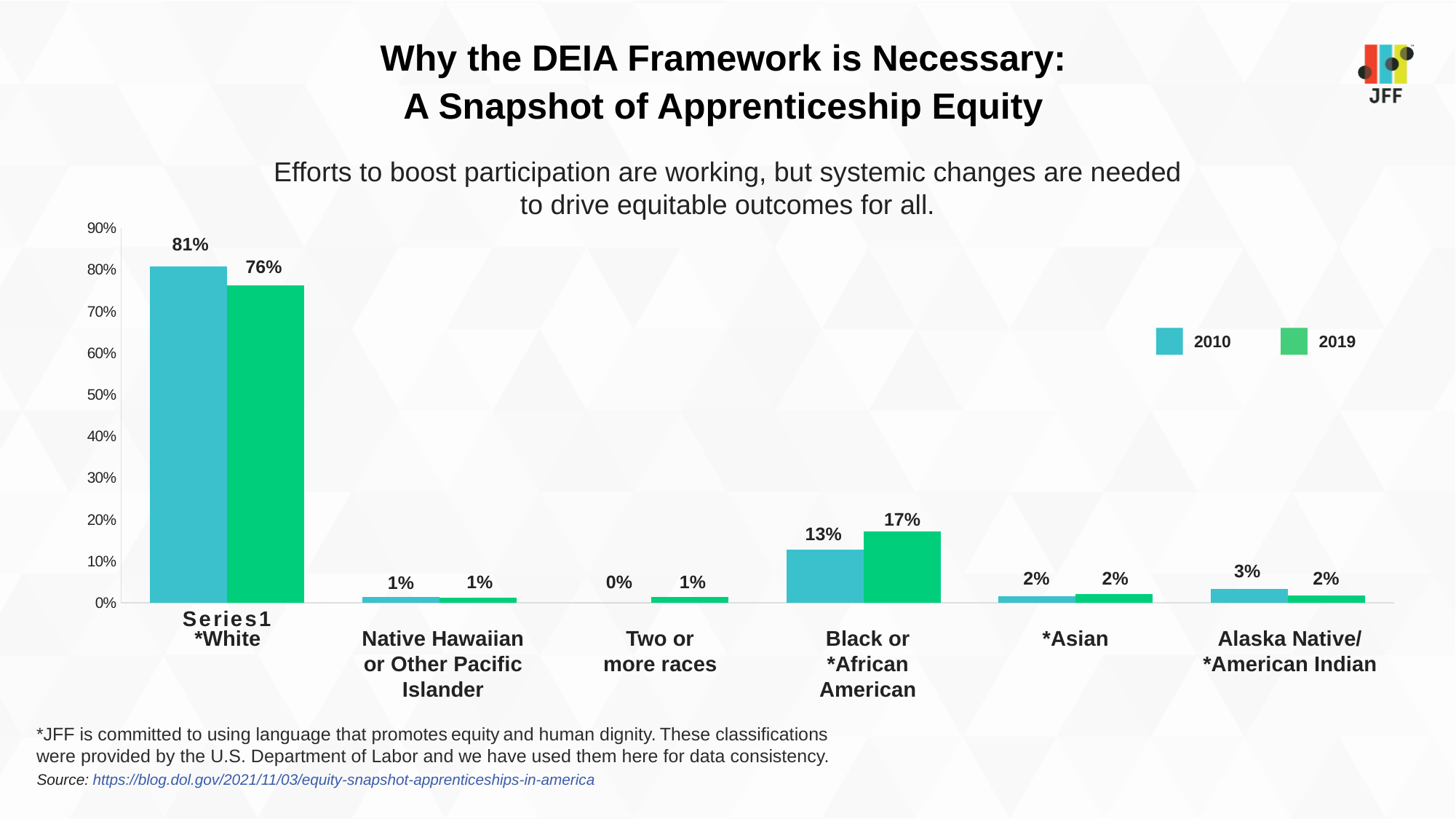
Which is larger for Black or African American: the 2010 value or the 2019 value? 2019 How many categories are shown on the x axis? 6 What was the value for Black or African American in 2019? 17% Which category has the highest value in 2019? White What was the value for Alaska Native/American Indian in 2010? 3% What was the value for White in 2019? 76% What kind of chart is shown on the slide? Bar chart By how many percentage points did the White share fall from 2010 to 2019? 5% How many series does the legend list? 2 What was the value for Two or more races in 2010? 0% What is the difference between the 2019 and 2010 values for Black or African American? 4% What was the value for White in 2010? 81%